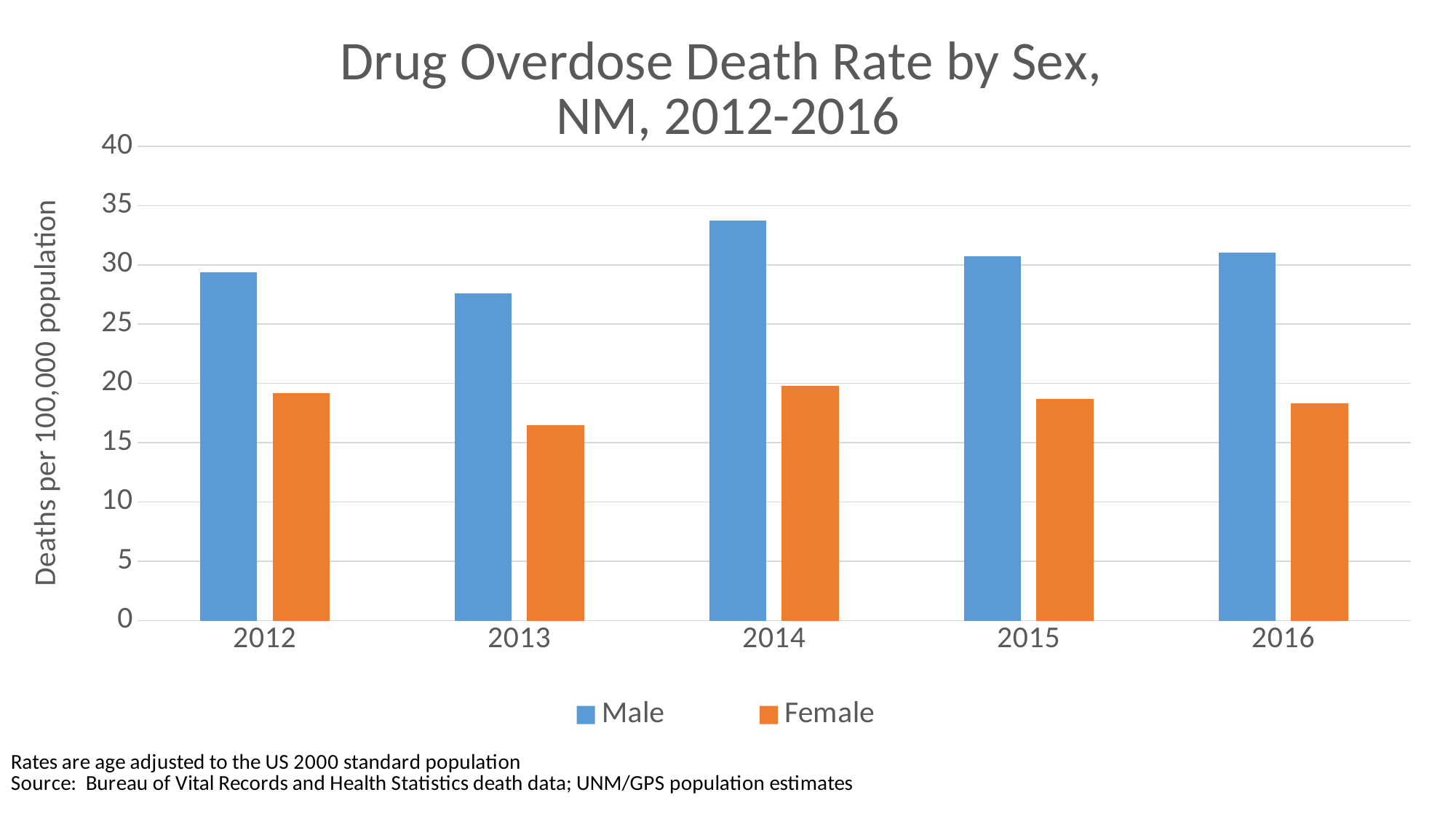
Is the Female value for 2015 greater or less than 15? greater Is the Male value for 2014 greater or less than 30? greater In which year is the Female death rate lowest? 2013 How many series does the legend list? 2 Does the Female death rate rise or fall from 2014 to 2016? fall What kind of chart is shown on the slide? bar chart In which year is the Male death rate highest? 2014 How many years are shown on the x axis? 5 In which year is the Male death rate lowest? 2013 Is the Female value for 2013 greater or less than 20? less In 2014, which is larger, the Male or the Female death rate? Male